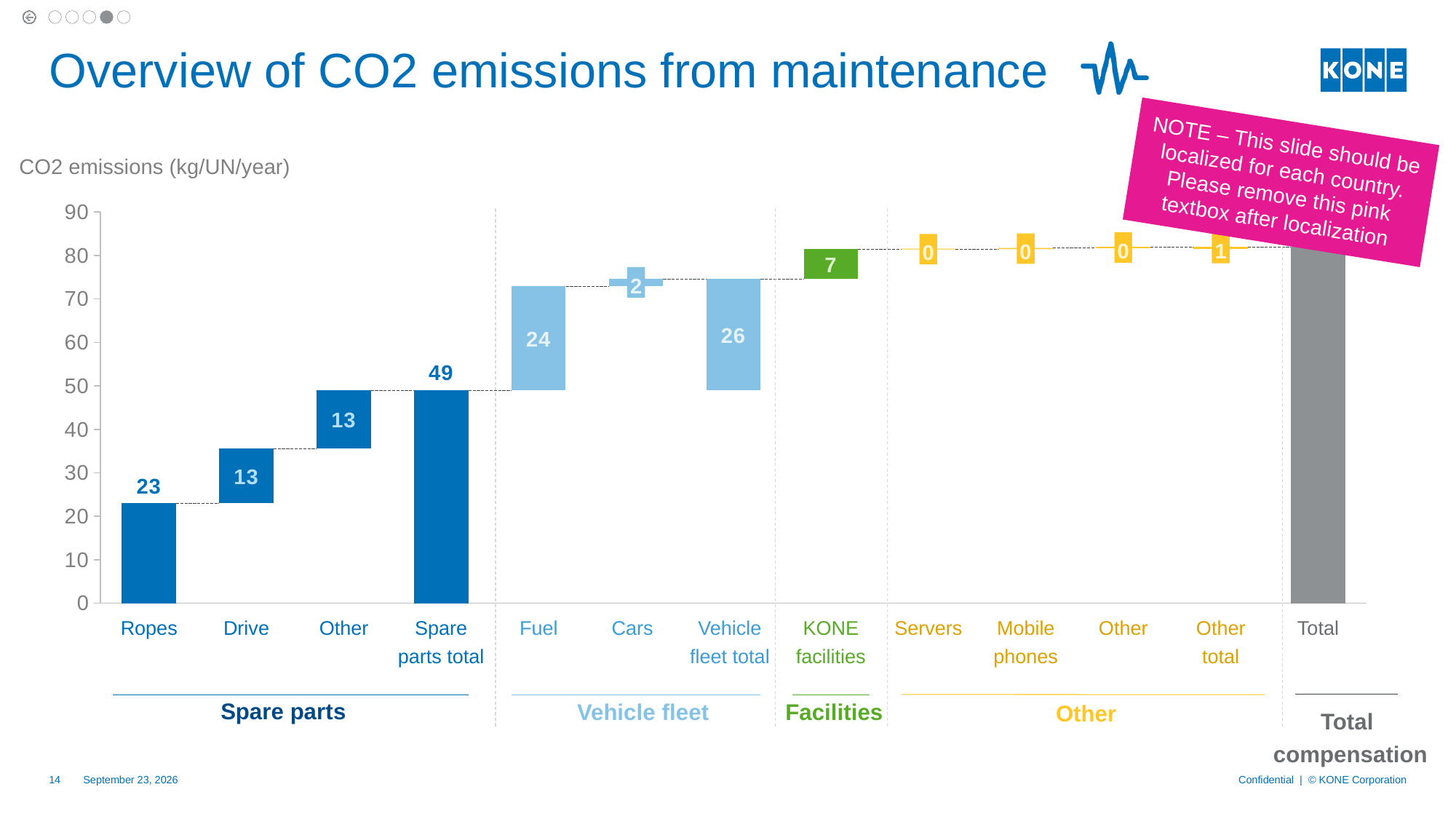
What unit is given for CO2 emissions on the chart's axis label? kg/UN/year What is the CO2 emissions value for Ropes? 23 What is the value of the Spare parts total bar? 49 Which of Ropes or Drive has the larger value? Ropes What is the value of the Vehicle fleet total bar? 26 What is the value shown for Fuel? 24 How many categories are shown on the x axis of the chart? 13 What is the value shown for KONE facilities? 7 What is the difference between the values for Fuel and Cars? 22 What is the difference between the values for Ropes and Drive? 10 What is the value shown for Other total? 1 Is the value of the Total bar greater or less than 90? less